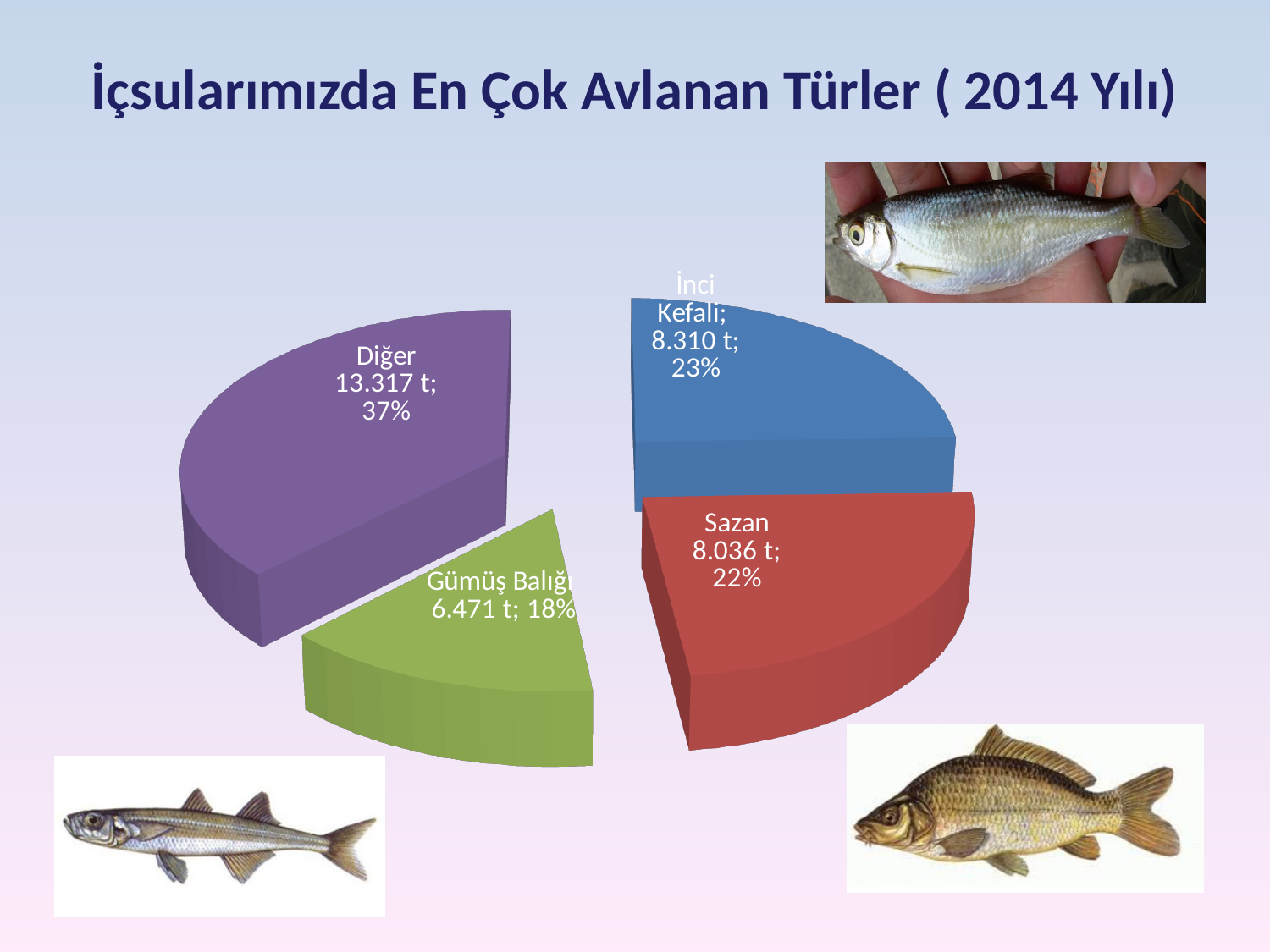
What is the catch amount shown for İnci Kefali? 8.310 t What is the catch amount shown for Gümüş Balığı? 6.471 t Which category has the smallest slice in the pie chart? Gümüş Balığı What kind of chart is shown on the slide? Pie chart Which category has the largest slice in the pie chart? Diğer What is the difference in catch amount between Sazan and Gümüş Balığı? 1.565 t What percentage share does Sazan have in the pie chart? 22% What is the title of the slide containing the pie chart? İçsularımızda En Çok Avlanan Türler ( 2014 Yılı) Which is larger, the catch amount for İnci Kefali or for Sazan? İnci Kefali What is the difference in catch amount between Diğer and İnci Kefali? 5.007 t How many slices does the pie chart have? 4 What percentage share does Diğer have in the pie chart? 37%